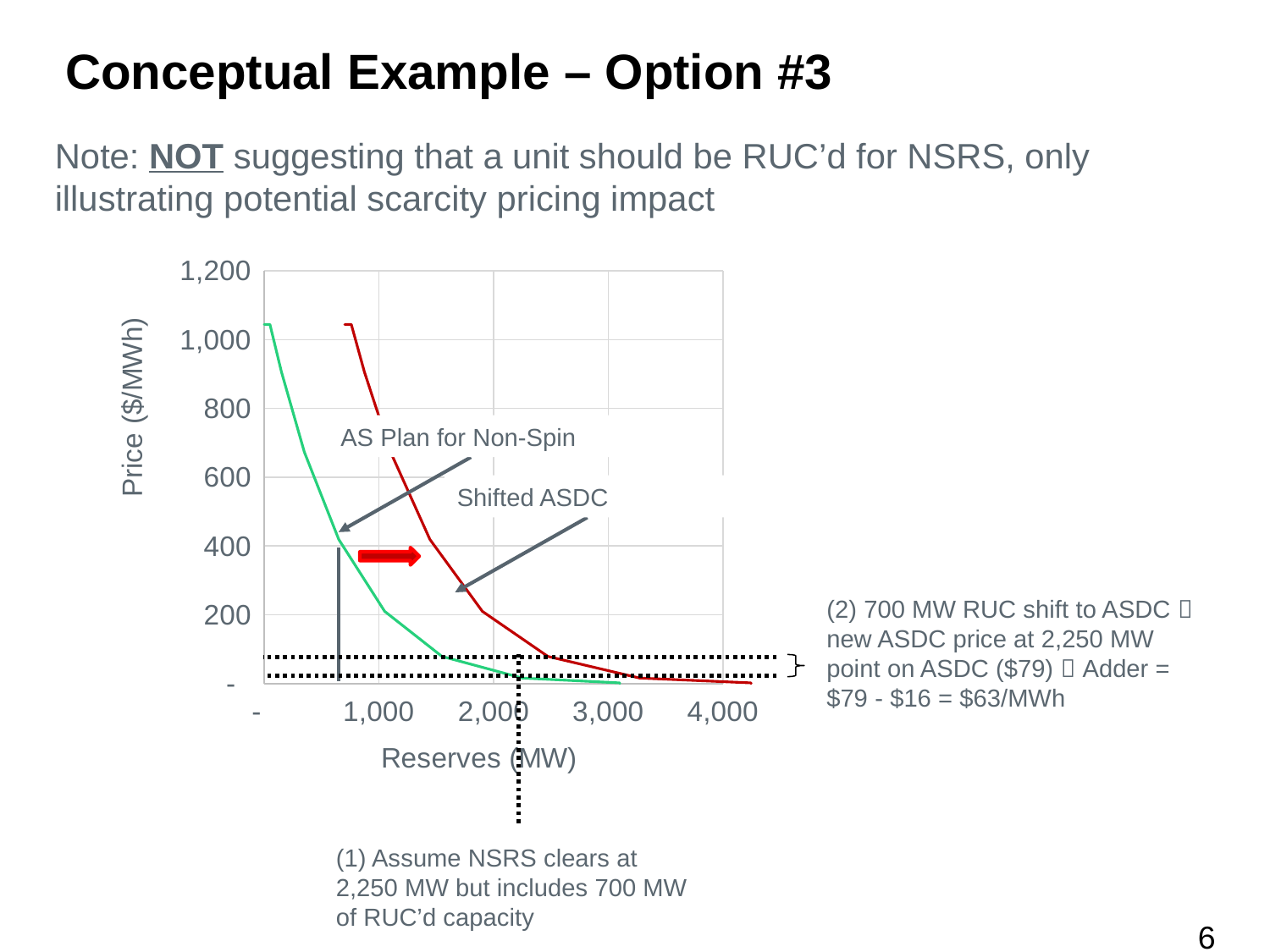
At 1,000 MW of reserves, is the price on the green curve greater or less than 400? less What kind of chart is shown on the slide? line chart At 2,000 MW of reserves, is the price on the Shifted ASDC (red) curve greater or less than 400? less What is the label of the y axis? Price ($/MWh) Do the curves rise or fall as reserves increase along the x axis? fall According to the annotation, what is the new ASDC price at the 2,250 MW point on the shifted ASDC? $79 According to the annotation, what is the resulting adder in $/MWh? $63/MWh How many curves are plotted on the chart? 2 What is the label of the x axis? Reserves (MW) At 1,000 MW of reserves, is the price on the Shifted ASDC (red) curve greater or less than 600? greater By how many MW is the ASDC shifted due to the RUC, according to the annotation? 700 MW At 1,000 MW of reserves, which curve shows the higher price, the green curve or the red Shifted ASDC curve? red Shifted ASDC curve